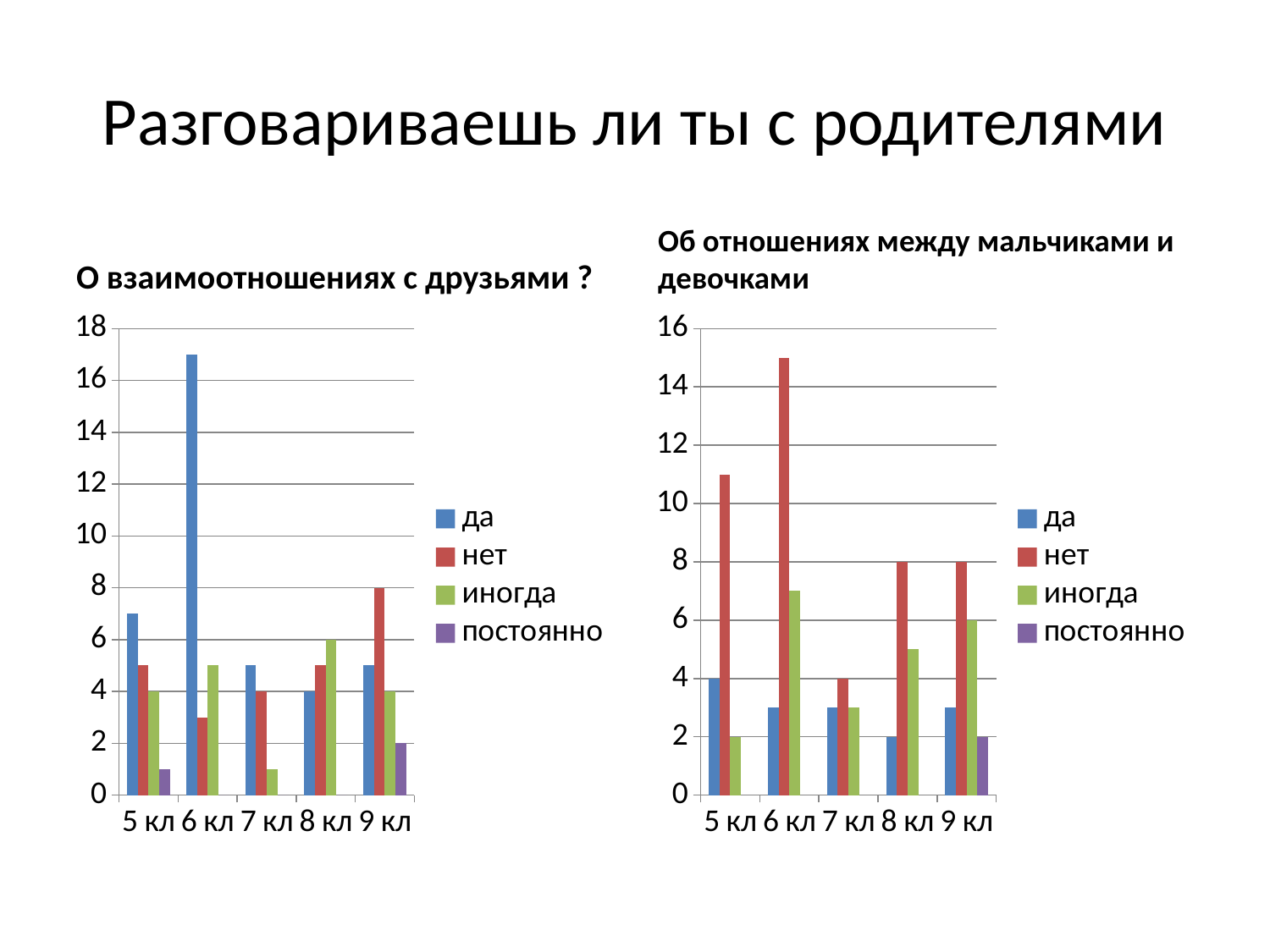
On the chart titled "Об отношениях между мальчиками и девочками", what is the difference between "нет" and "да" in 8 кл? 6 On the chart titled "О взаимоотношениях с друзьями ?", which is larger in 9 кл: "да" or "нет"? нет On the chart titled "О взаимоотношениях с друзьями ?", is the value for "да" in 6 кл greater or less than 16? greater How many series does the legend of the chart titled "Об отношениях между мальчиками и девочками" list? 4 On the chart titled "Об отношениях между мальчиками и девочками", which class has the highest "нет" bar? 6 кл On the chart titled "О взаимоотношениях с друзьями ?", which class has the highest "да" bar? 6 кл On the chart titled "Об отношениях между мальчиками и девочками", is the value for "нет" in 5 кл greater or less than 10? greater On the chart titled "О взаимоотношениях с друзьями ?", what is the value for "нет" in 9 кл? 8 On the chart titled "Об отношениях между мальчиками и девочками", what is the value for "иногда" in 9 кл? 6 On the chart titled "Об отношениях между мальчиками и девочками", what is the value for "да" in 5 кл? 4 What kind of chart is the chart titled "О взаимоотношениях с друзьями ?"? bar chart On the chart titled "О взаимоотношениях с друзьями ?", what is the value for "иногда" in 8 кл? 6